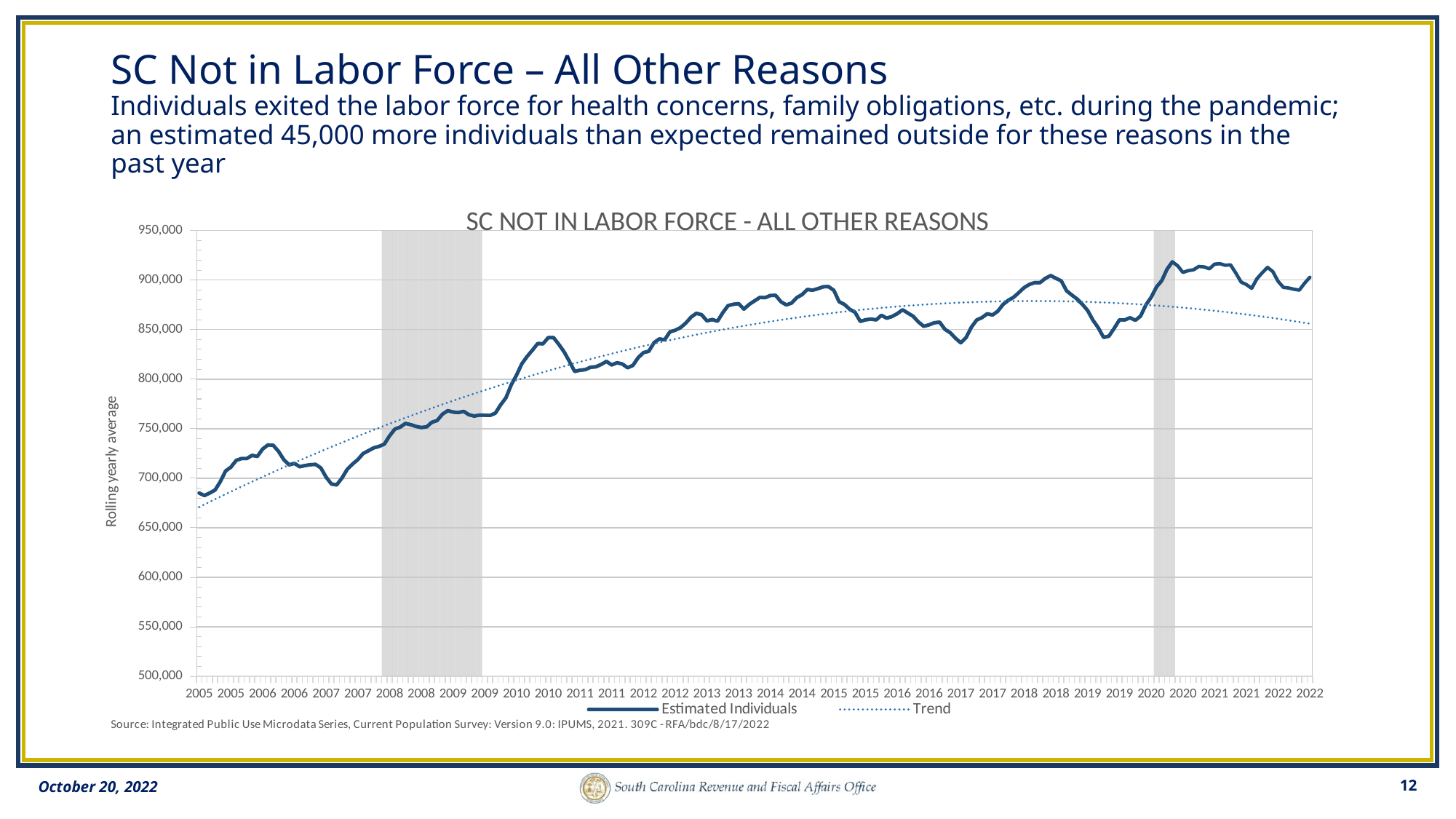
Is the value of Estimated Individuals at its low point in 2017 greater or less than 850,000? less Is the value of Estimated Individuals at the start of 2005 greater or less than 700,000? less Is the peak value of Estimated Individuals in 2020 greater or less than 900,000? greater How many series does the chart legend list? 2 What kind of chart is shown on the slide? Line chart What is the label on the vertical axis of the chart? Rolling yearly average Overall, does the Estimated Individuals line rise or fall from 2005 to 2022? Rise In which year does the Estimated Individuals line reach its lowest value? 2005 Which is larger: the Estimated Individuals value at the start of 2005 or at the 2020 peak? 2020 peak What are the two series named in the chart legend? Estimated Individuals and Trend